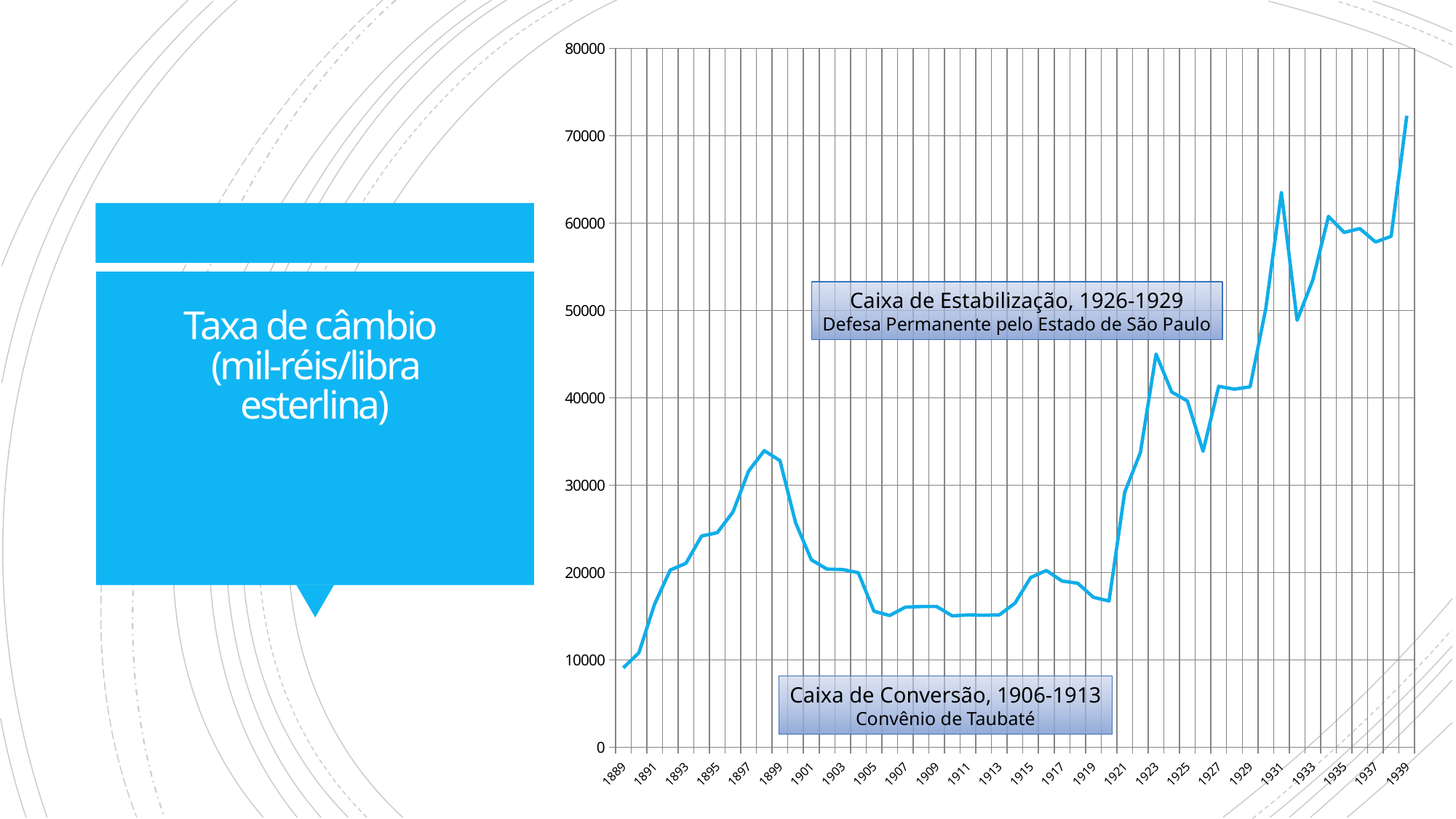
How many year labels are shown on the x axis? 26 Does the exchange rate rise or fall between 1899 and 1905? fall What period does the annotation 'Caixa de Conversão' refer to? 1906-1913 Is the value for 1923 greater or less than 40000? greater Which year has the highest exchange rate value on the chart? 1939 What kind of chart is shown on the slide? line chart Is the value for 1913 greater or less than 20000? less Is the value for 1905 greater or less than 20000? less Which year has the lowest exchange rate value on the chart? 1889 Which is larger, the value for 1899 or the value for 1923? 1923